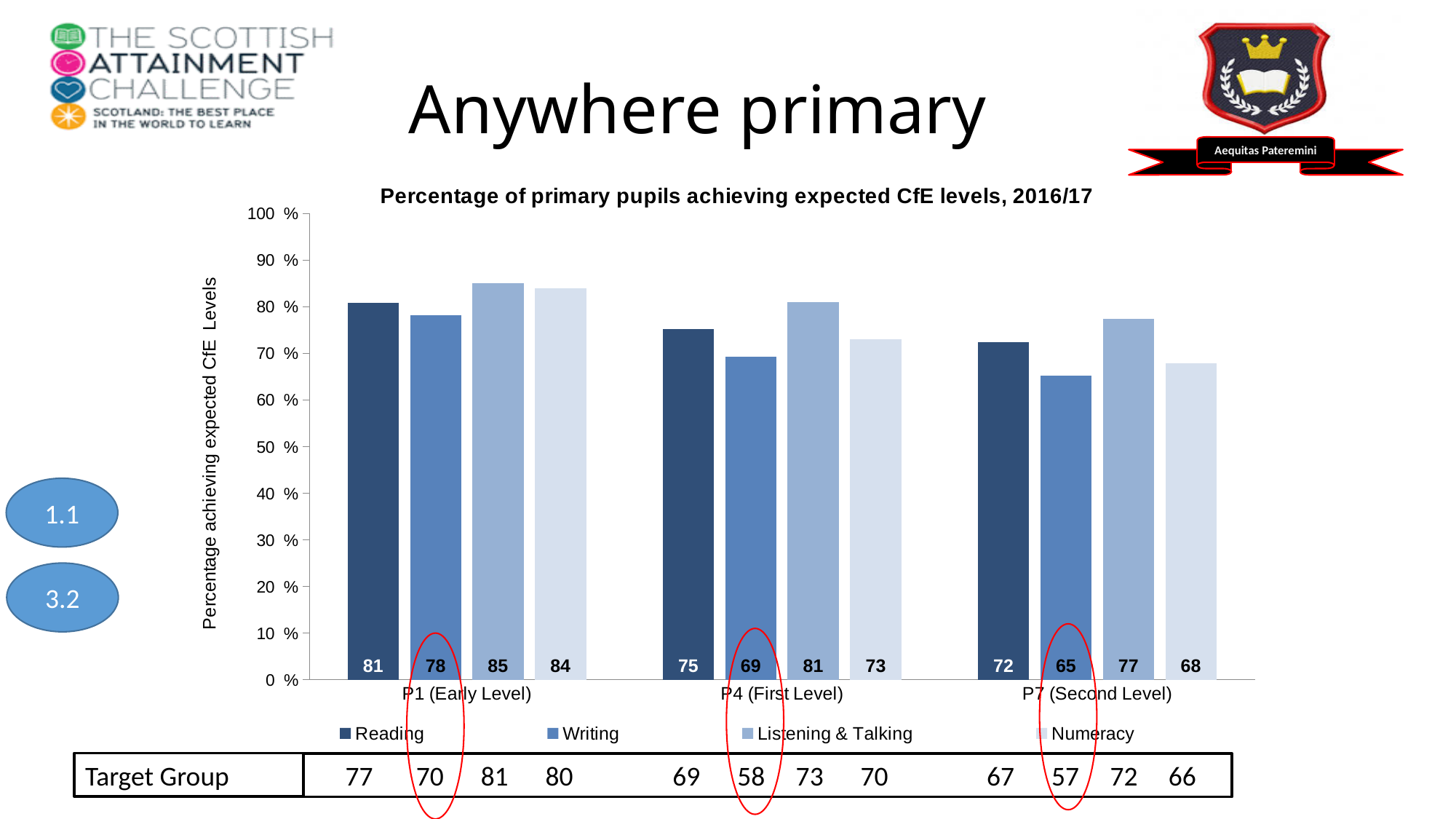
What is the difference between the Reading and Writing values at P4 (First Level)? 6 Which series has the highest value at P1 (Early Level)? Listening & Talking Which series has the lowest value at P7 (Second Level)? Writing Which is larger at P7 (Second Level): Numeracy or Listening & Talking? Listening & Talking How many series does the legend list? 4 How many categories are shown on the x axis? 3 What is the value for Reading at P1 (Early Level)? 81 What kind of chart is shown? Bar chart What is the value for Listening & Talking at P4 (First Level)? 81 Do the Writing values rise or fall from P1 (Early Level) to P7 (Second Level)? Fall What is the value for Writing at P7 (Second Level)? 65 What is the value for Numeracy at P1 (Early Level)? 84